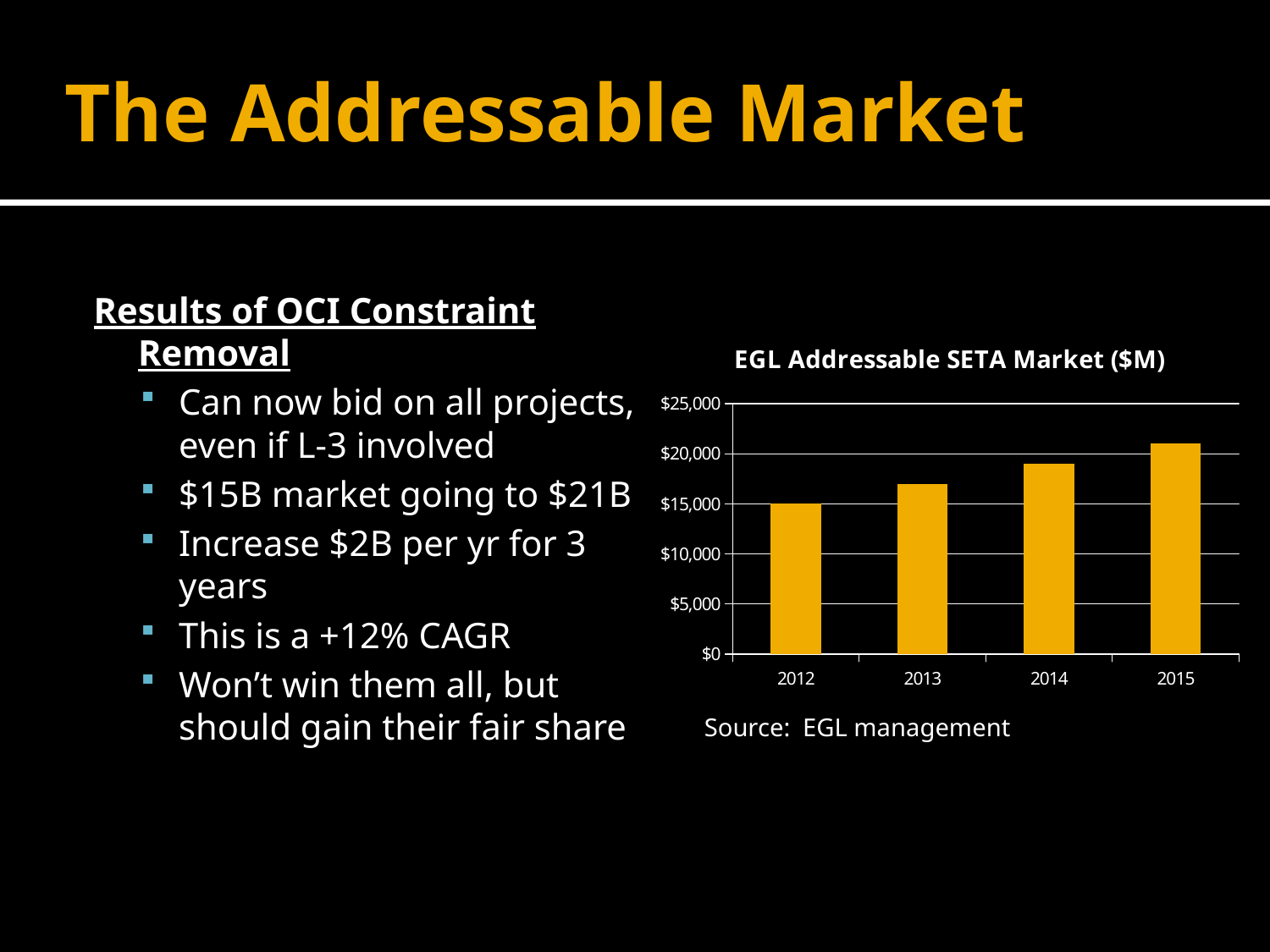
Is the value for 2014 greater or less than $20,000? less Which is larger, the value for 2013 or the value for 2014? 2014 Which year has the lowest value in the chart? 2012 How many years are shown on the x axis of the chart? 4 What is the value for 2012 in the chart? $15,000 Is the value for 2013 greater or less than $15,000? greater Do the values rise or fall from 2012 to 2015? rise What is the title of the chart? EGL Addressable SETA Market ($M) What type of chart is shown on the slide? bar chart Which year has the highest value in the chart? 2015 What colour are the bars in the chart? yellow/gold Is the value for 2015 greater or less than $20,000? greater